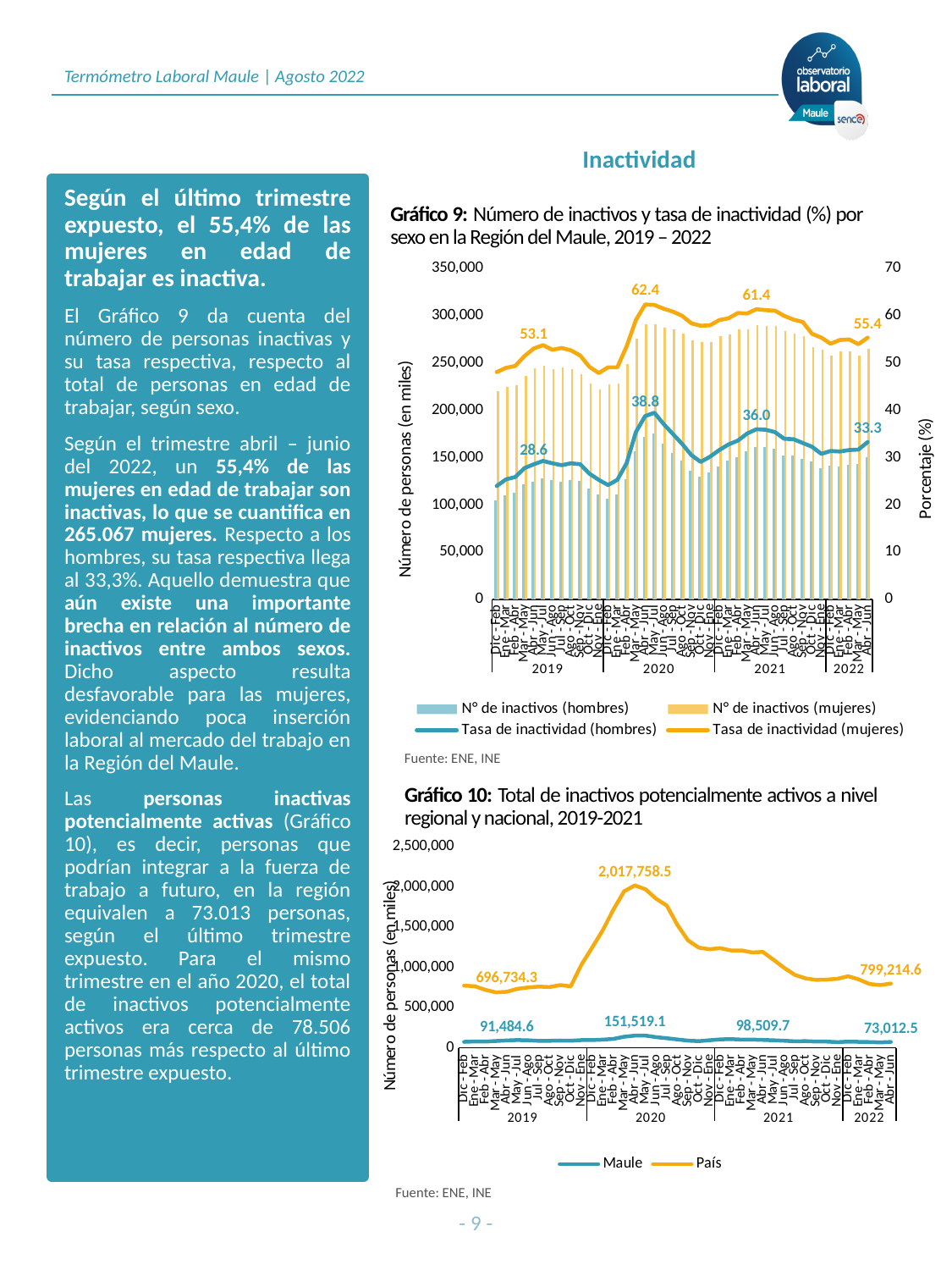
In Gráfico 9, what is the labelled inactivity rate for men (Tasa de inactividad (hombres)) at the last point, Abr - Jun 2022? 33.3 In Gráfico 9, what is the highest labelled inactivity rate for women (Tasa de inactividad (mujeres))? 62.4 In Gráfico 10, what is the difference between the Maule labels 151,519.1 and 73,012.5? 78,506.6 In Gráfico 9, what is the lowest labelled inactivity rate for men? 28.6 In Gráfico 9, is the number of inactive women (N° de inactivos (mujeres)) in the last bar greater or less than 200,000? greater In Gráfico 10, which series has the larger value at the first point, País or Maule? País In Gráfico 10, what is the labelled peak value for the País series? 2,017,758.5 How many series does the legend of Gráfico 9 list? 4 What kind of chart is Gráfico 10? Line chart In Gráfico 9, what is the difference between the labelled women's rate 62.4 and the labelled men's rate 38.8 in 2020? 23.6 In Gráfico 10, what is the labelled value for Maule at the last point, Abr - Jun 2022? 73,012.5 In Gráfico 9, what is the labelled inactivity rate for women at the last point, Abr - Jun 2022? 55.4